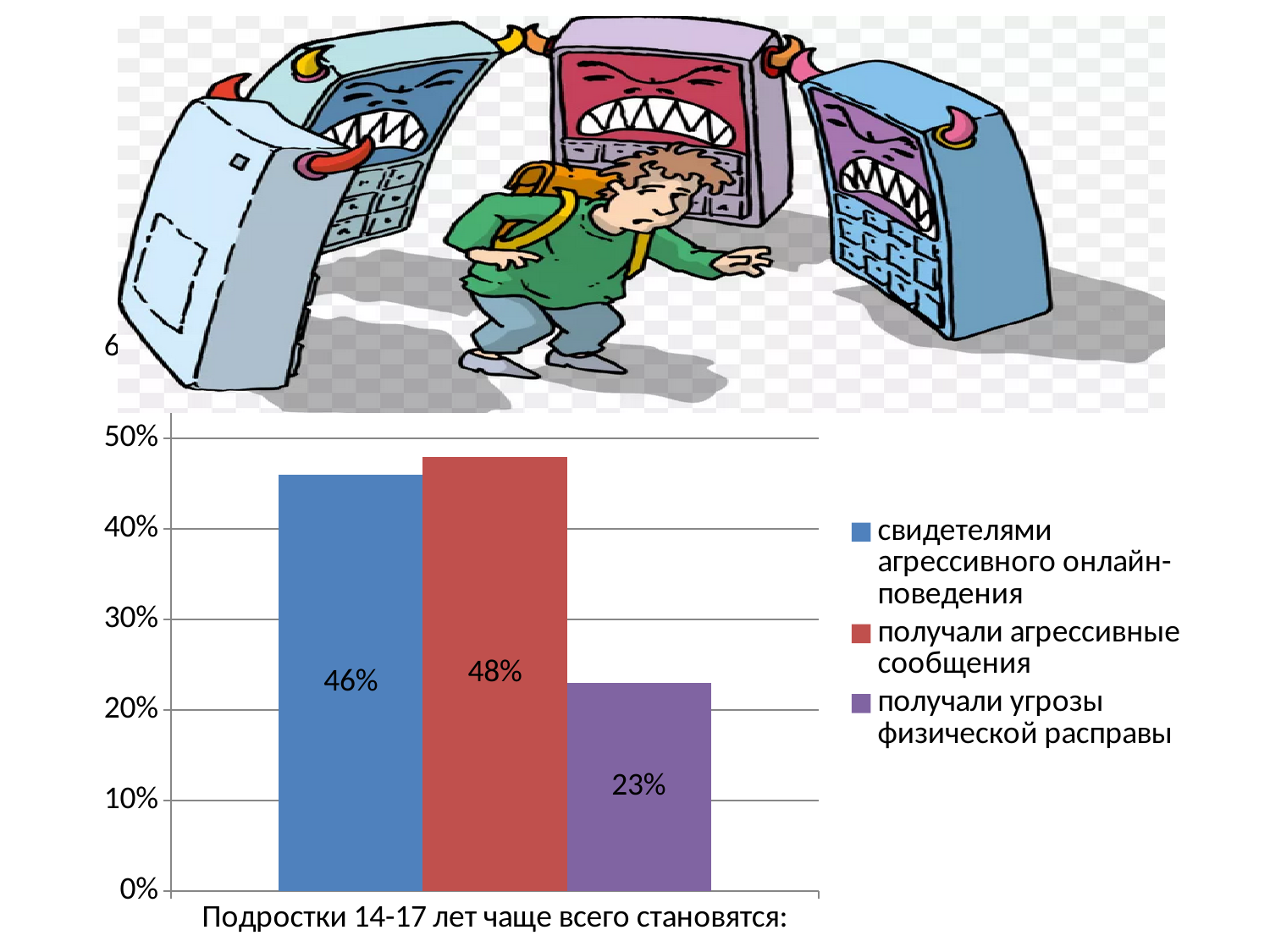
What is the value for 'получали угрозы физической расправы'? 23% What is the label shown on the x axis of the chart? Подростки 14-17 лет чаще всего становятся: Which series has the highest value? получали агрессивные сообщения What kind of chart is shown on the slide? bar chart Is the value for 'получали угрозы физической расправы' greater or less than 30%? less What is the value for 'получали агрессивные сообщения'? 48% How many series does the legend list? 3 What is the difference between the values for 'получали агрессивные сообщения' and 'свидетелями агрессивного онлайн-поведения'? 2% What is the difference between the values for 'получали агрессивные сообщения' and 'получали угрозы физической расправы'? 25% Which series has the lowest value? получали угрозы физической расправы Which is larger: the value for 'свидетелями агрессивного онлайн-поведения' or for 'получали угрозы физической расправы'? свидетелями агрессивного онлайн-поведения What is the value for 'свидетелями агрессивного онлайн-поведения'? 46%